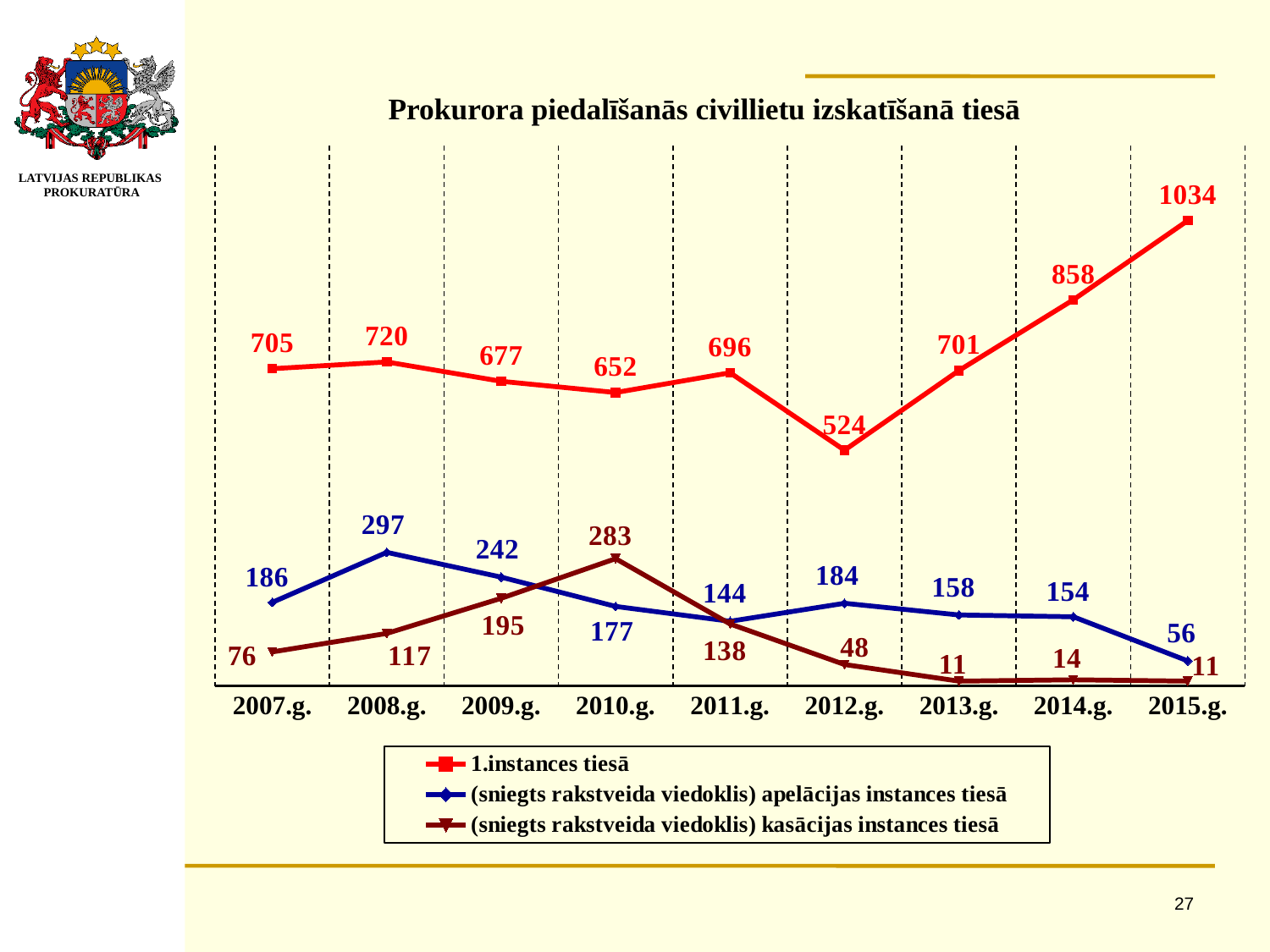
In which year is the value for 1.instances tiesā lowest? 2012.g. What is the value for 1.instances tiesā in 2015.g.? 1034 How many series does the legend list? 3 In which year is the value for (sniegts rakstveida viedoklis) apelācijas instances tiesā highest? 2008.g. How many years are shown on the x axis? 9 Which is larger in 2009.g.: the apelācijas instances tiesā value or the kasācijas instances tiesā value? apelācijas instances tiesā What kind of chart is shown on the slide? line chart What is the difference between the 1.instances tiesā values for 2015.g. and 2014.g.? 176 Does the value for 1.instances tiesā rise or fall from 2012.g. to 2015.g.? rise What is the value for (sniegts rakstveida viedoklis) kasācijas instances tiesā in 2010.g.? 283 What is the value for (sniegts rakstveida viedoklis) apelācijas instances tiesā in 2008.g.? 297 What is the title of the chart? Prokurora piedalīšanās civillietu izskatīšanā tiesā